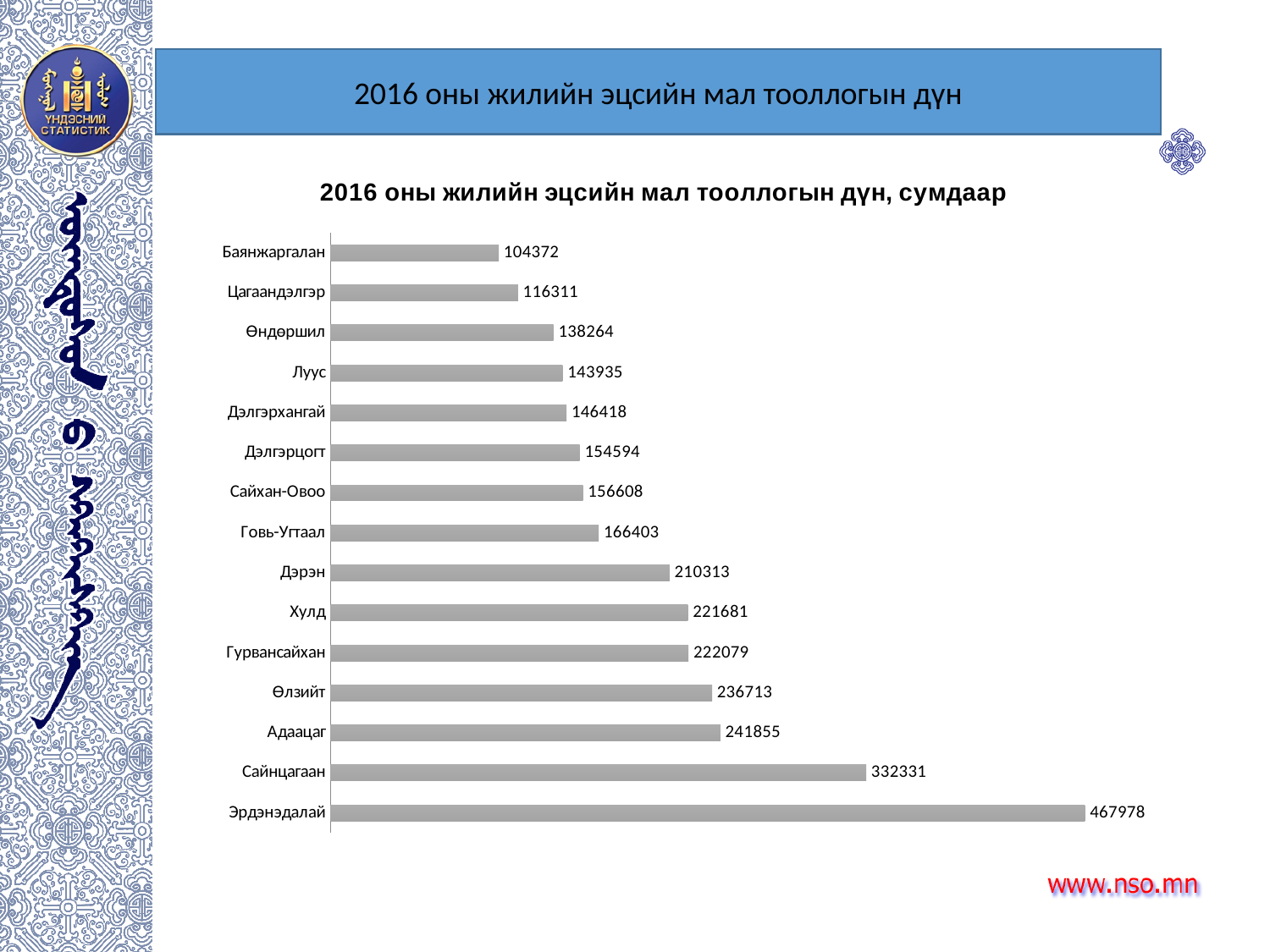
What is the value for Дэлгэрцогт? 154594 Which category has the highest value? Эрдэнэдалай Which category has the lowest value? Баянжаргалан Which is larger, the value for Сайнцагаан or the value for Адаацаг? Сайнцагаан What is the value for Эрдэнэдалай? 467978 What is the value for Хулд? 221681 What is the difference between the values for Эрдэнэдалай and Сайнцагаан? 135647 How many categories are shown in the chart? 15 What kind of chart is shown on the slide? Bar chart Which is larger, the value for Дэрэн or the value for Луус? Дэрэн What is the difference between the values for Дэрэн and Говь-Угтаал? 43910 What is the title of the chart? 2016 оны жилийн эцсийн мал тооллогын дүн, сумдаар